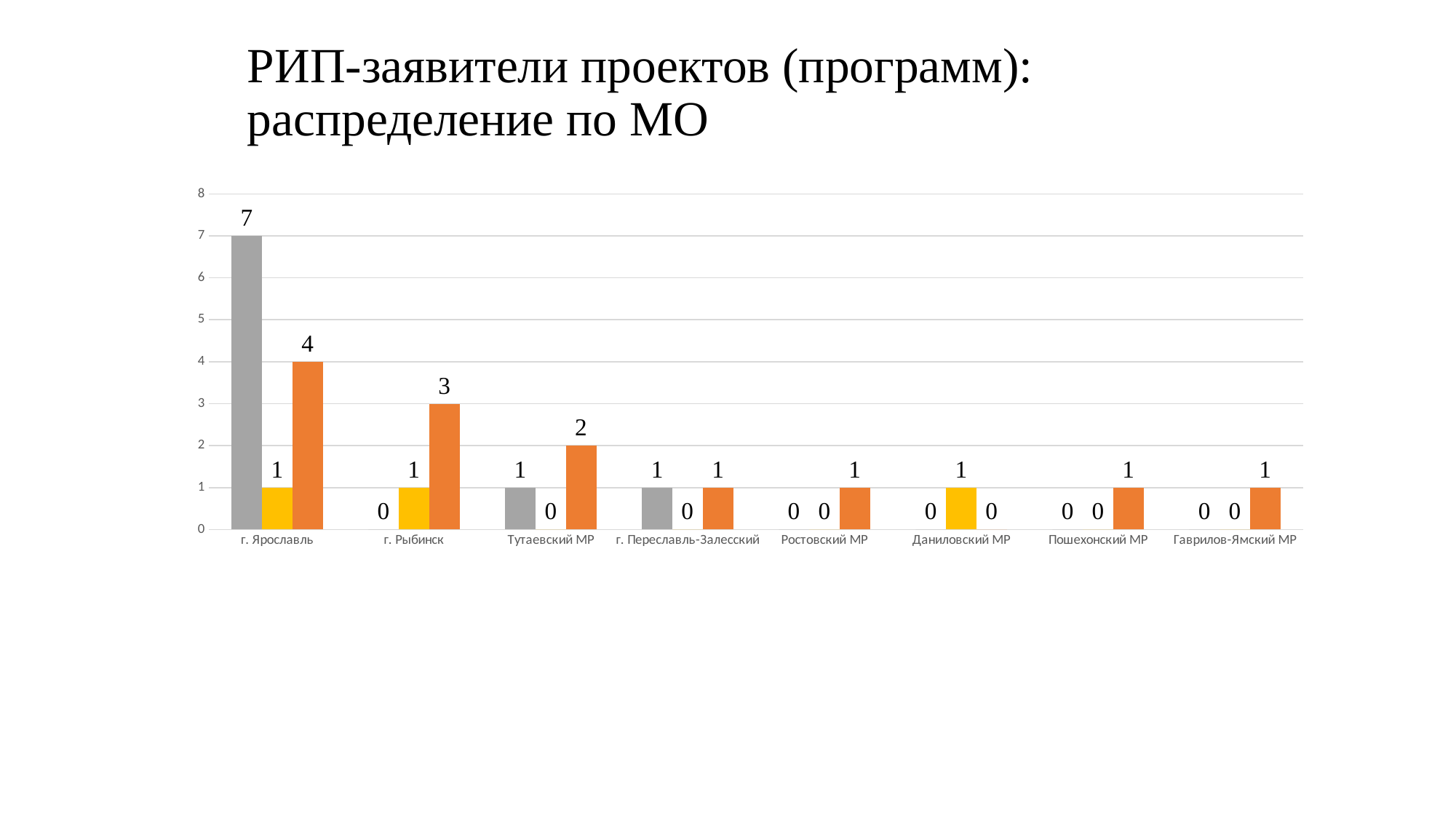
What is the value of the yellow bar for Даниловский МР? 1 What is the title of the slide? РИП-заявители проектов (программ): распределение по МО What type of chart is shown on the slide? bar chart Which is larger for г. Рыбинск: the yellow bar or the orange bar? the orange bar What is the value of the orange bar for Тутаевский МР? 2 What is the value of the grey bar for г. Ярославль? 7 How many municipalities (categories) are shown on the x axis? 8 Which municipality has the highest single bar in the chart? г. Ярославль What is the difference between the grey bar and the orange bar for г. Ярославль? 3 What is the value of the grey bar for Ростовский МР? 0 What is the total of the three bars for г. Ярославль? 12 What is the value of the orange bar for г. Рыбинск? 3